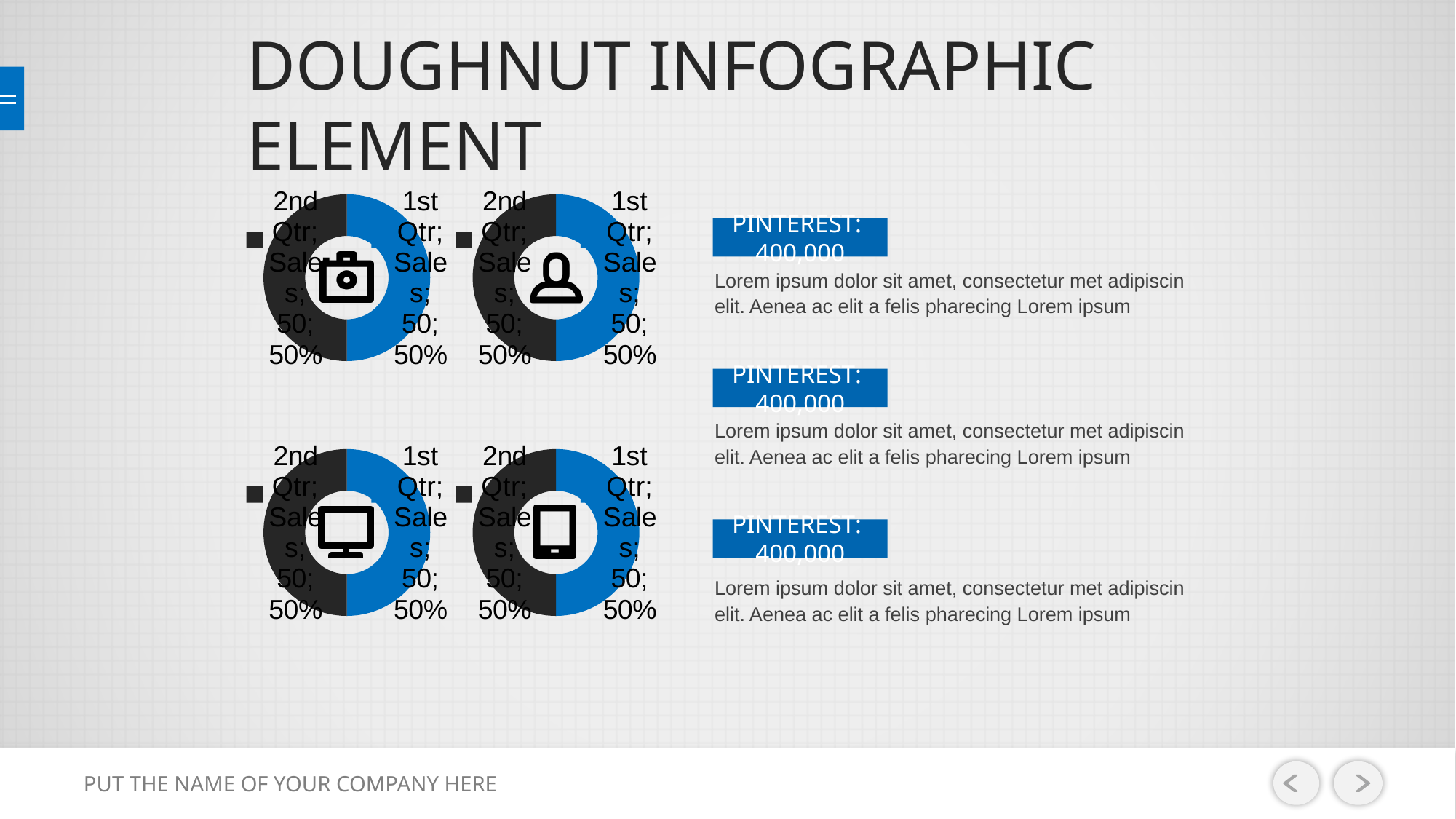
In the top-right doughnut chart (person icon), what is the total of the two slice values? 100 In the top-left doughnut chart (camera icon), how many slices are there? 2 How many doughnut charts are shown on the slide? 4 In the top-left doughnut chart (camera icon), what is the value for 1st Qtr Sales? 50 In the top-left doughnut chart (camera icon), which slice is shown in dark grey? 2nd Qtr In the bottom-right doughnut chart (tablet icon), which slice is shown in blue? 1st Qtr In the bottom-right doughnut chart (tablet icon), what is the value for 1st Qtr Sales? 50 In the bottom-right doughnut chart (tablet icon), what share of the doughnut does 2nd Qtr Sales take? 50% In the top-right doughnut chart (person icon), what is the value for 2nd Qtr Sales? 50 In the bottom-left doughnut chart (monitor icon), what is the difference between the 1st Qtr and 2nd Qtr Sales values? 0 In the bottom-left doughnut chart (monitor icon), what share of the doughnut does 1st Qtr Sales take? 50% What kind of chart is the top-left chart with the camera icon? Doughnut chart